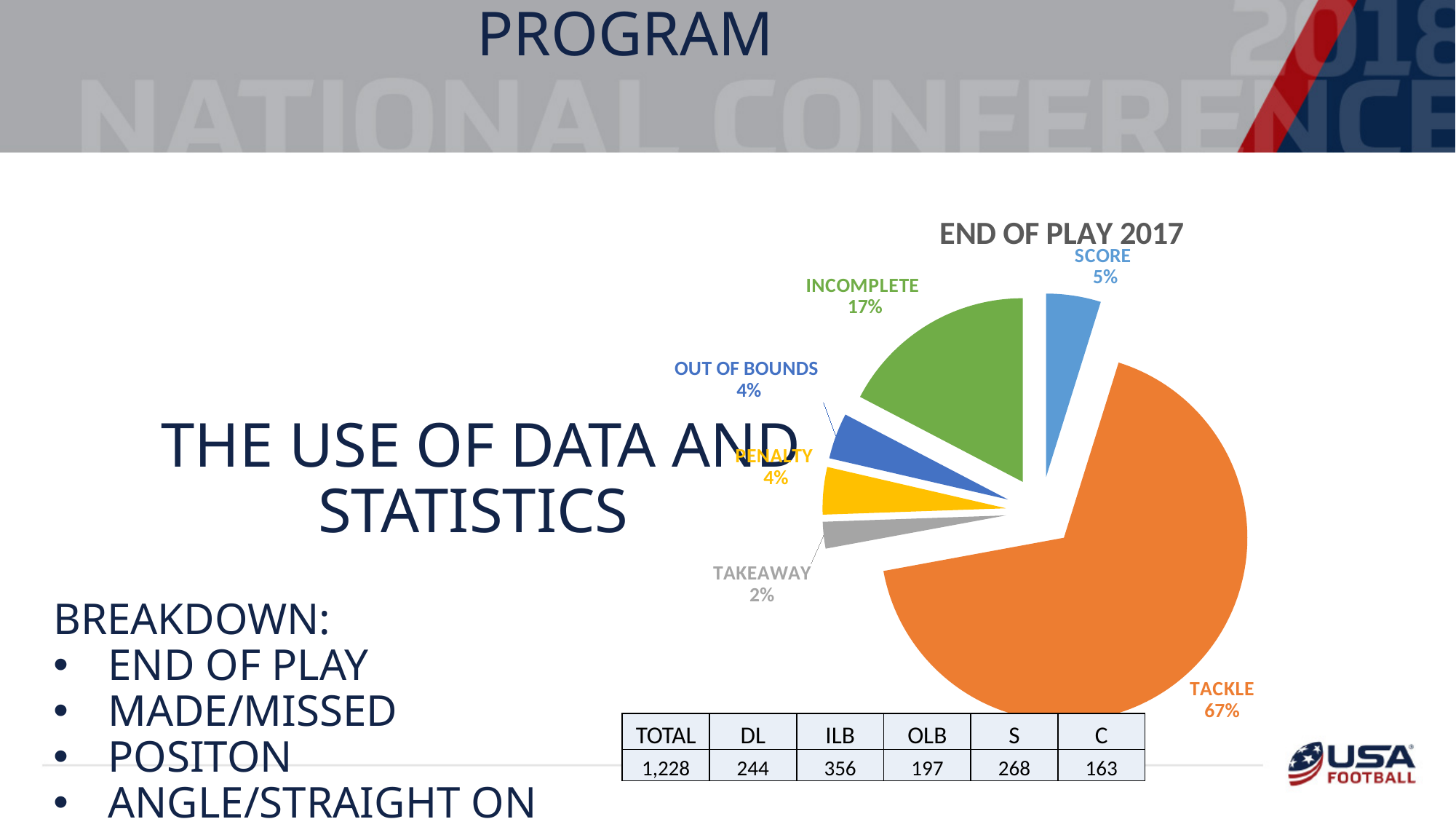
What percentage is shown for INCOMPLETE? 17% What is the difference in percentage points between TACKLE and INCOMPLETE? 50 What is the title of the chart? END OF PLAY 2017 What percentage is shown for TAKEAWAY? 2% Which category has the largest slice of the pie? TACKLE Which is larger, the share for SCORE or the share for TAKEAWAY? SCORE What type of chart is shown on the slide? pie chart What percentage is shown for SCORE? 5% What colour is the TACKLE slice? orange How many slices does the pie chart have? 6 What share of the pie does TACKLE represent? 67% Which category has the smallest slice of the pie? TAKEAWAY